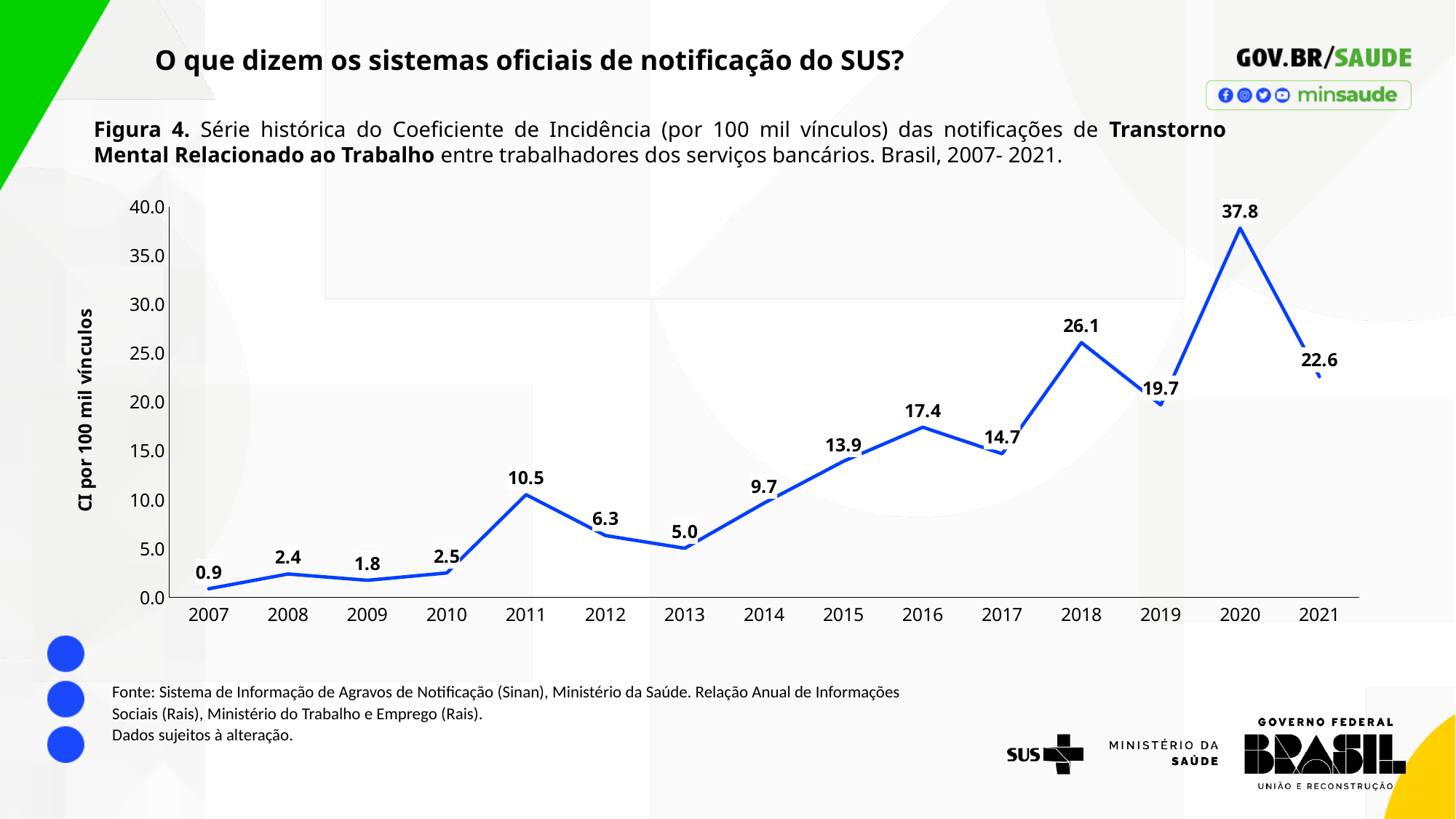
Which year has the lowest incidence coefficient? 2007 What is the incidence coefficient (CI por 100 mil vínculos) for 2011? 10.5 Which year has a larger value, 2012 or 2013? 2012 Which year has the highest incidence coefficient? 2020 What is the value plotted for 2007? 0.9 What is the label of the y axis? CI por 100 mil vínculos How many years are plotted on the x axis? 15 Is the value for 2019 greater or less than 15.0? greater What kind of chart is shown on the slide? line chart What is the difference between the values for 2020 and 2021? 15.2 What is the value plotted for 2018? 26.1 What is the difference between the values for 2016 and 2017? 2.7